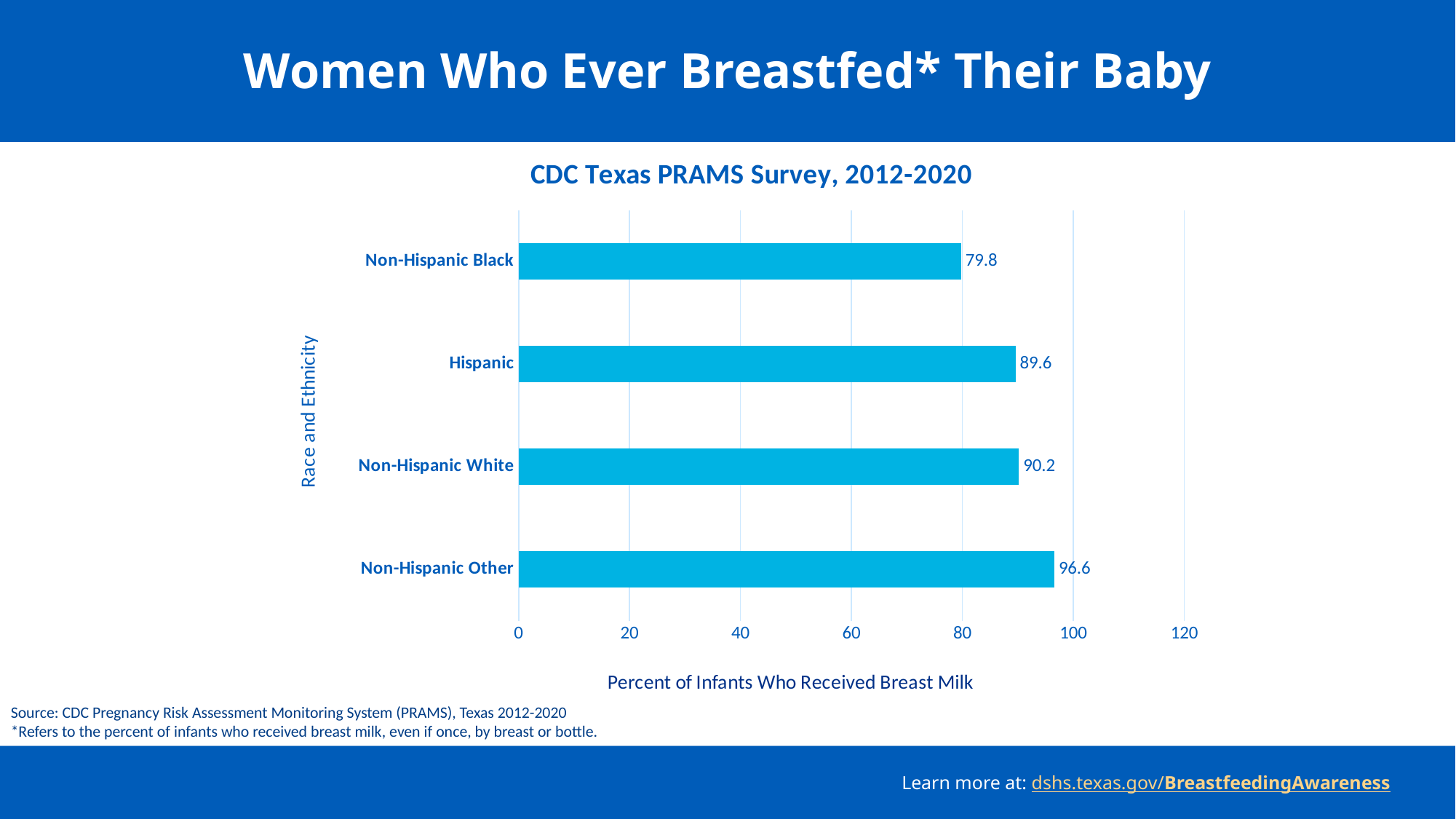
What kind of chart is shown on the slide? Bar chart How many race and ethnicity categories are shown in the chart? 4 What is the title of the chart? CDC Texas PRAMS Survey, 2012-2020 What is the difference between the values for Non-Hispanic White and Hispanic? 0.6 What is the value for Non-Hispanic Black? 79.8 Which race and ethnicity group has the highest percent of infants who received breast milk? Non-Hispanic Other What is the value for Non-Hispanic Other? 96.6 Which is larger, the value for Hispanic or the value for Non-Hispanic Black? Hispanic What is the difference between the values for Non-Hispanic Other and Non-Hispanic Black? 16.8 What is the value for Hispanic? 89.6 Which race and ethnicity group has the lowest percent of infants who received breast milk? Non-Hispanic Black What is the value for Non-Hispanic White? 90.2